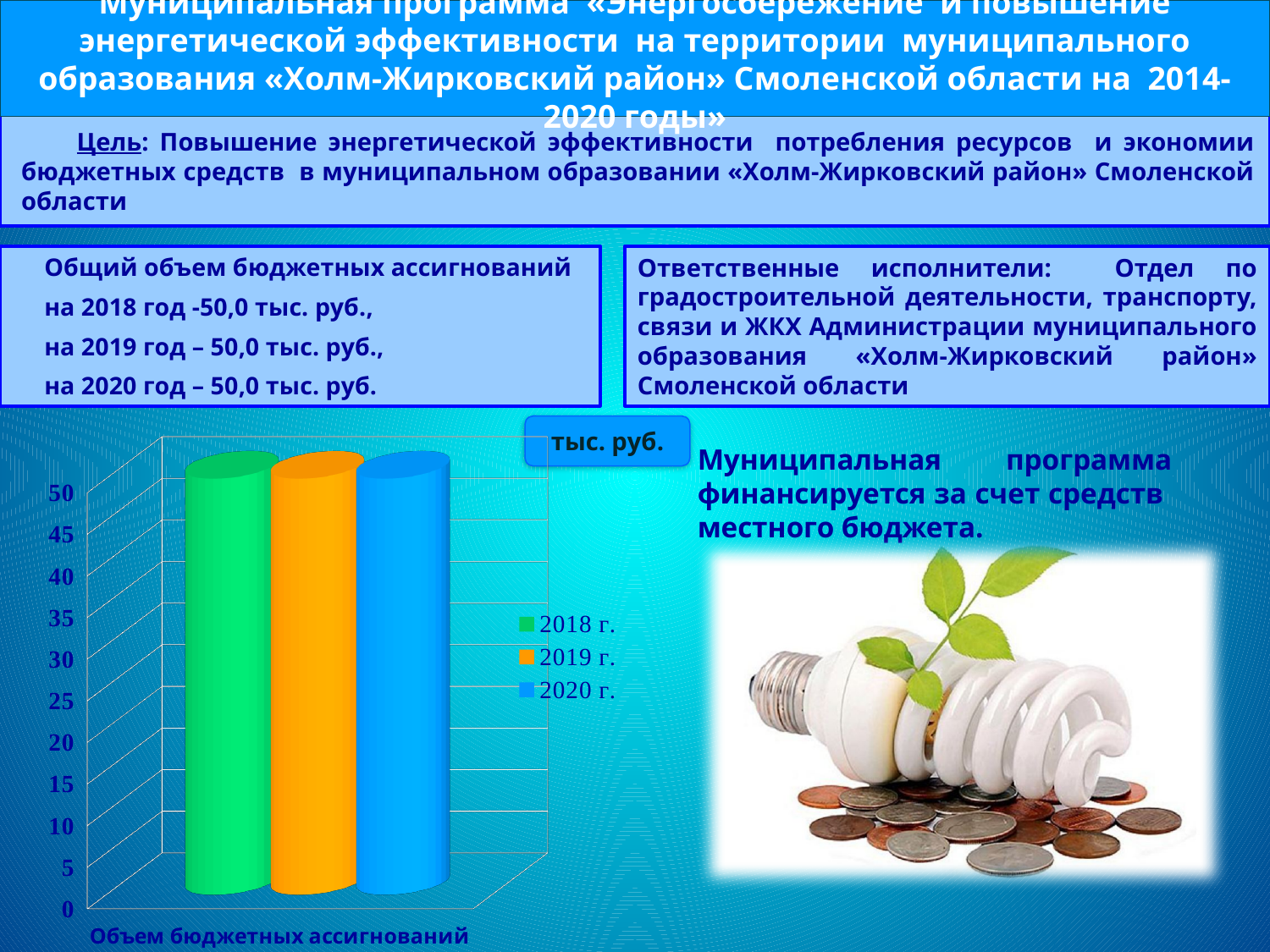
Is the value for 2020 г. greater or less than 40? greater What kind of chart is shown on the slide? bar chart How many series does the chart legend list? 3 What is the title of the chart? тыс. руб. How many categories are shown on the x axis of the chart? 1 What is the difference between the values for 2019 г. and 2018 г.? 0 What is the value of the bar for 2020 г.? 50 What is the value of the bar for 2019 г.? 50 What is the label of the category on the x axis? Объем бюджетных ассигнований What is the value of the bar for 2018 г.? 50 Which colour represents 2019 г. in the chart legend? orange Is the value for 2018 г. greater or less than 30? greater